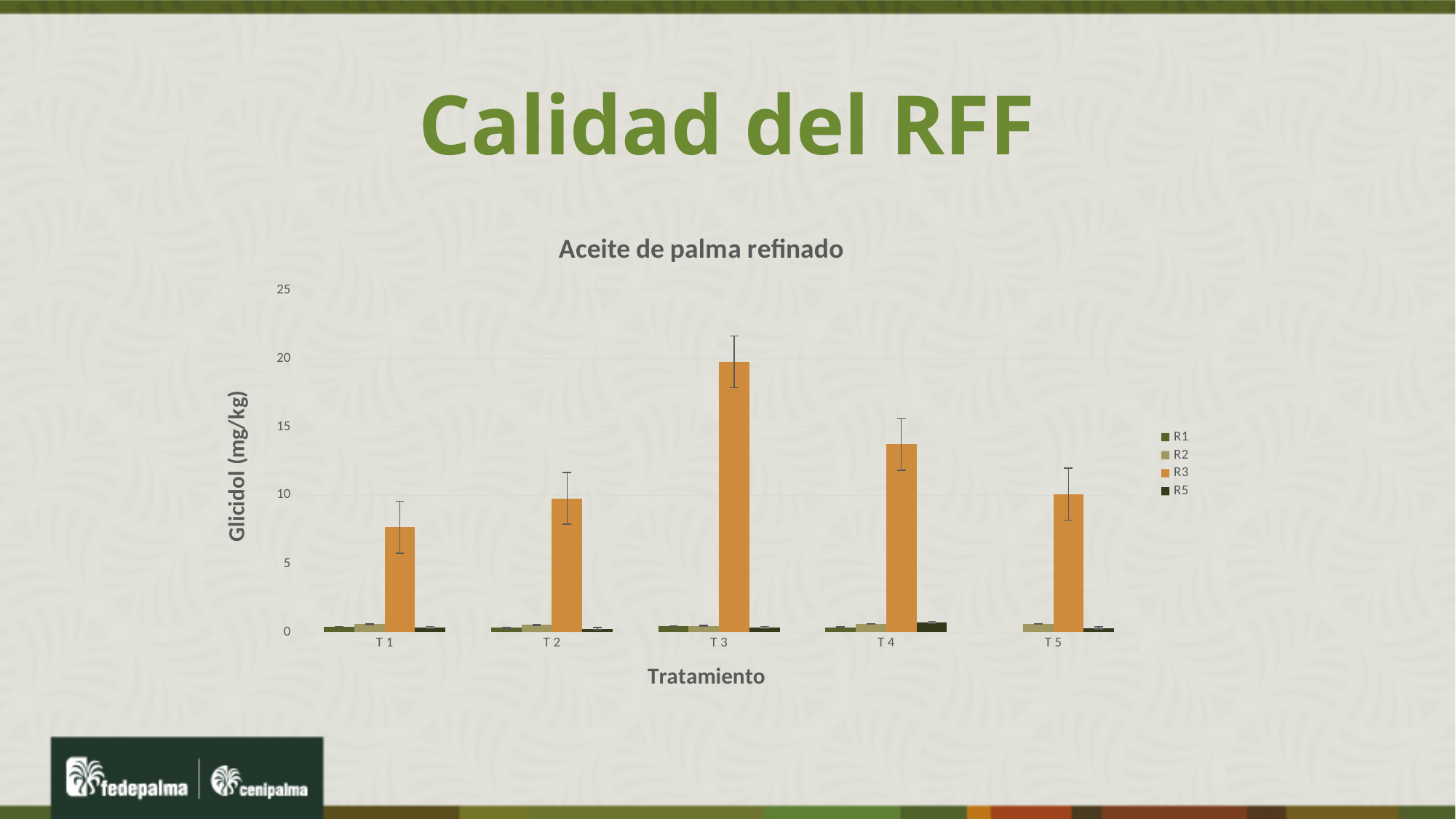
Which treatment has the lowest R3 value? T 1 Is the R3 value for T 3 greater or less than 15? greater Is the R3 value for T 3 greater or less than 25? less What is the title of the chart? Aceite de palma refinado What kind of chart is shown on the slide? bar chart Is the R3 value for T 1 greater or less than 10? less Which is larger, the R3 value for T 3 or the R3 value for T 4? T 3 What is the label of the chart's y axis? Glicidol (mg/kg) How many treatment categories are shown on the x axis of the chart? 5 How many series does the chart's legend list? 4 Which treatment has the highest R3 value? T 3